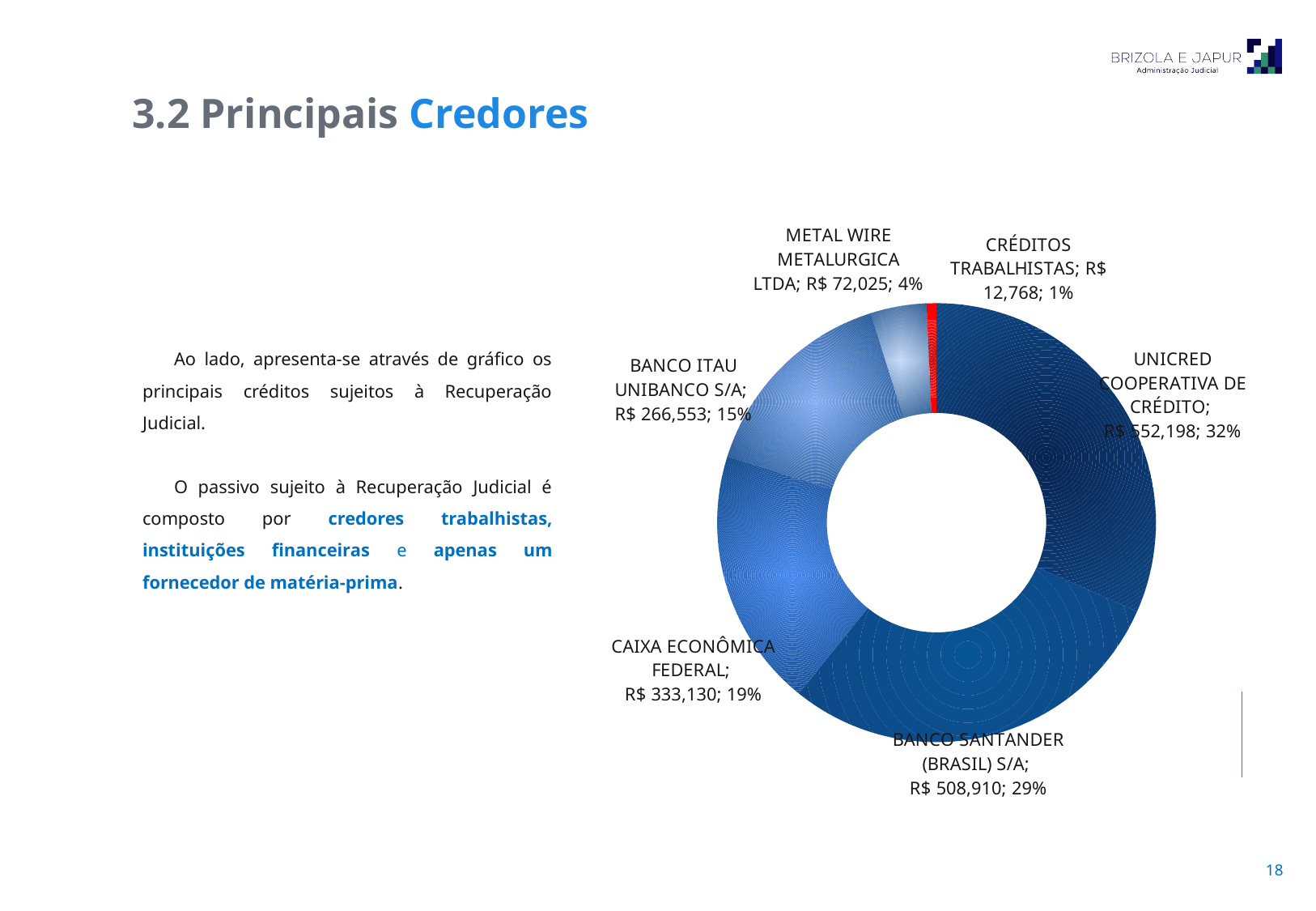
What is the difference between the values for CAIXA ECONÔMICA FEDERAL and BANCO ITAU UNIBANCO S/A? R$ 66,577 Which creditor has the largest slice in the chart? UNICRED COOPERATIVA DE CRÉDITO Which is larger, the value for METAL WIRE METALURGICA LTDA or the value for CRÉDITOS TRABALHISTAS? METAL WIRE METALURGICA LTDA What is the value shown for BANCO ITAU UNIBANCO S/A? R$ 266,553 What is the difference between the values for UNICRED COOPERATIVA DE CRÉDITO and BANCO SANTANDER (BRASIL) S/A? R$ 43,288 What percentage share does CAIXA ECONÔMICA FEDERAL hold in the chart? 19% What is the value shown for BANCO SANTANDER (BRASIL) S/A? R$ 508,910 What percentage share does METAL WIRE METALURGICA LTDA hold in the chart? 4% How many creditor categories are shown in the chart? 6 What is the value shown for UNICRED COOPERATIVA DE CRÉDITO? R$ 552,198 What kind of chart is shown on the slide? Pie chart (donut) Which creditor has the smallest slice in the chart? CRÉDITOS TRABALHISTAS